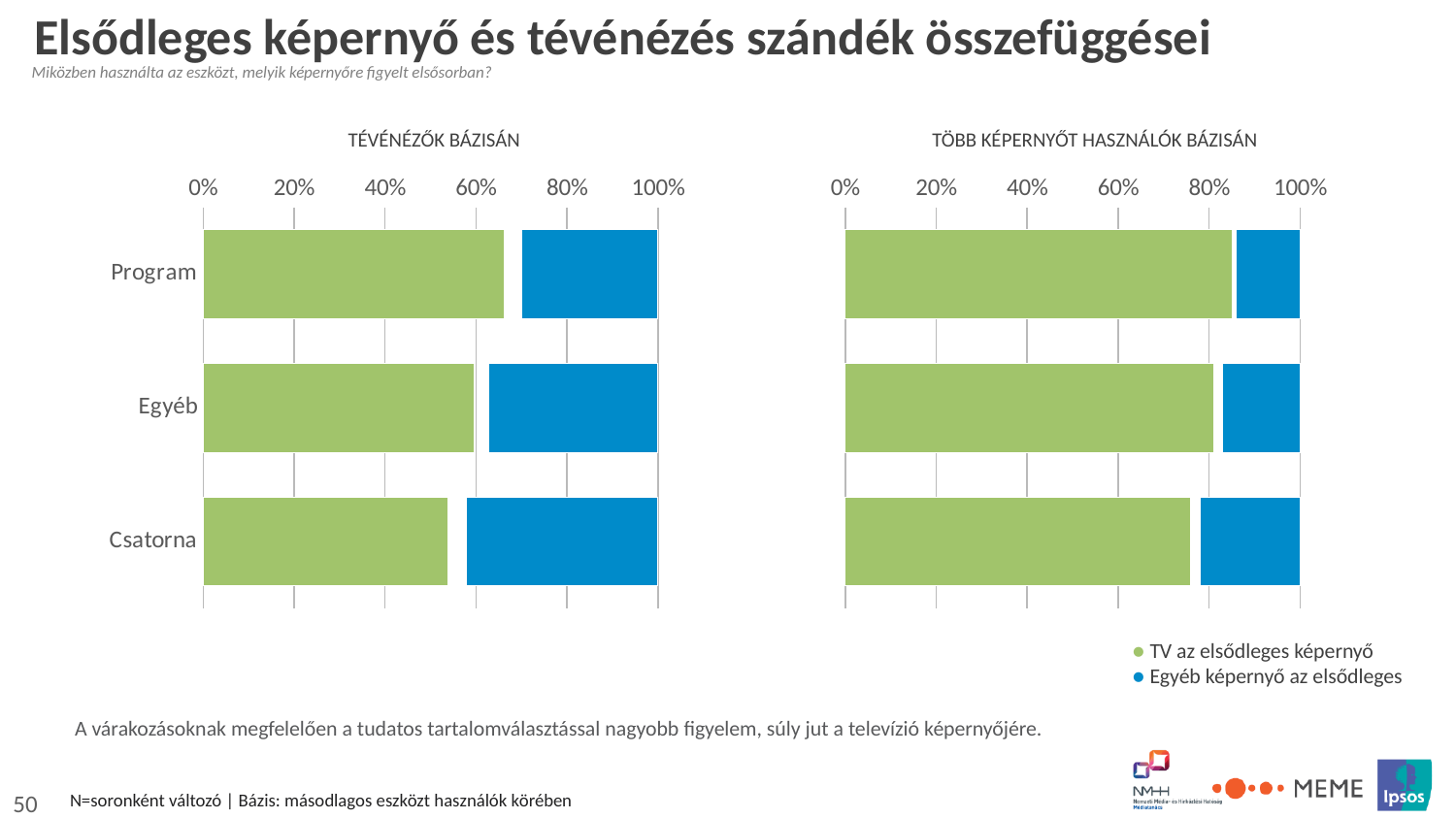
In the left chart (TÉVÉNÉZŐK BÁZISÁN), which category has the lowest share for 'TV az elsődleges képernyő'? Csatorna In the right chart (TÖBB KÉPERNYŐT HASZNÁLÓK BÁZISÁN), is the 'TV az elsődleges képernyő' value for Csatorna greater or less than 80%? less In the right chart (TÖBB KÉPERNYŐT HASZNÁLÓK BÁZISÁN), is the 'TV az elsődleges képernyő' value for Program greater or less than 80%? greater In the left chart (TÉVÉNÉZŐK BÁZISÁN), is the 'TV az elsődleges képernyő' value for Program greater or less than 60%? greater In the left chart (TÉVÉNÉZŐK BÁZISÁN), which category has the highest share for 'TV az elsődleges képernyő'? Program How many categories are shown on the left chart (TÉVÉNÉZŐK BÁZISÁN)? 3 What kind of chart is the left chart titled TÉVÉNÉZŐK BÁZISÁN? Stacked bar chart How many series does the legend list for the charts? 2 In the right chart (TÖBB KÉPERNYŐT HASZNÁLÓK BÁZISÁN), which is larger for 'TV az elsődleges képernyő': Program or Csatorna? Program In the right chart (TÖBB KÉPERNYŐT HASZNÁLÓK BÁZISÁN), which category has the largest share for 'Egyéb képernyő az elsődleges'? Csatorna Which colour represents 'TV az elsődleges képernyő' in the charts? Green